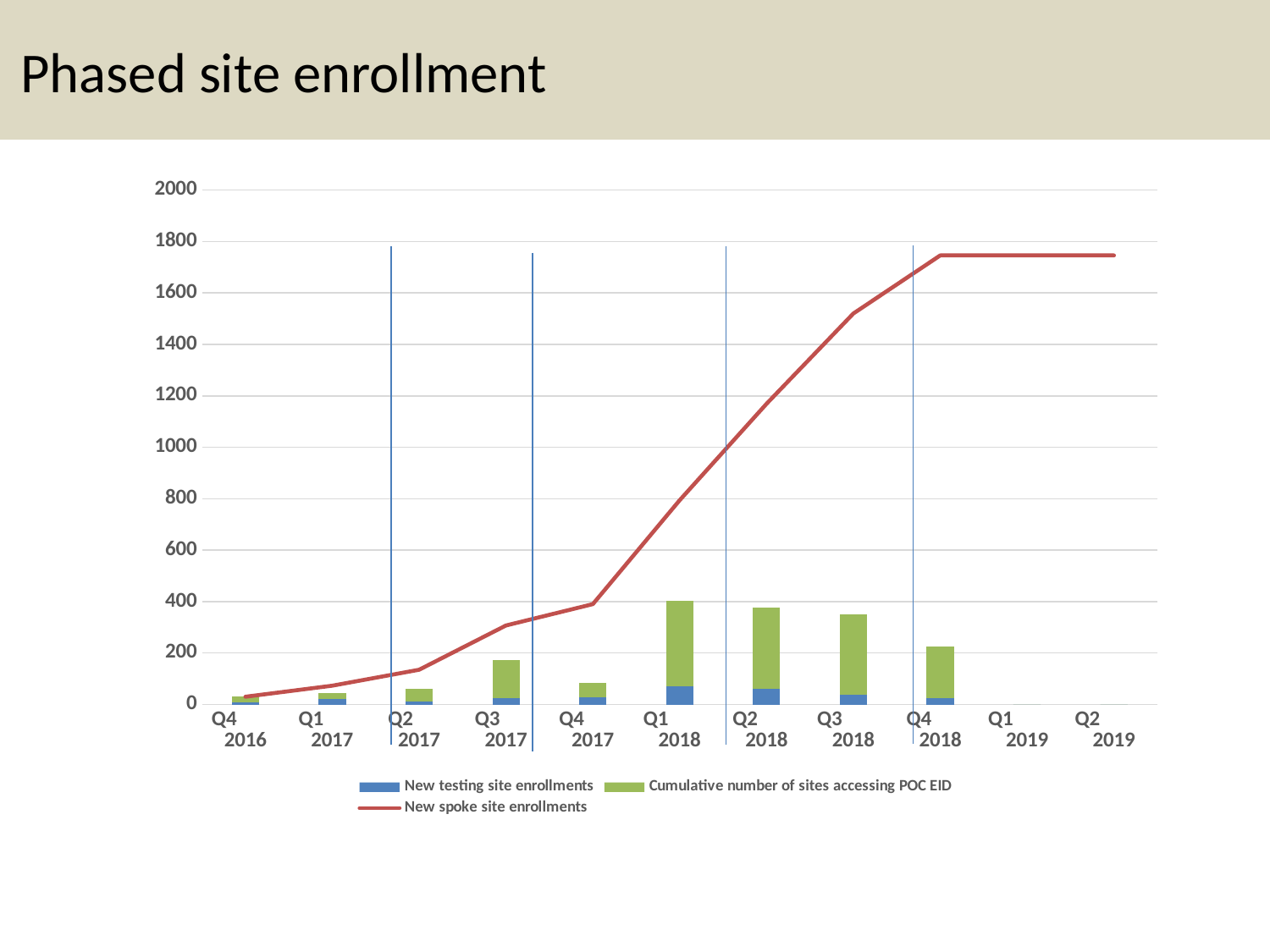
Does the New spoke site enrollments line rise or fall from Q4 2016 to Q4 2018? Rise How many quarters are shown on the x axis of the chart? 11 Which series is drawn as a red line in the chart? New spoke site enrollments Is the value of the New spoke site enrollments line at Q3 2018 greater or less than 1400? greater Which quarter has the tallest stacked bar in the chart? Q1 2018 What is the title of the slide's chart? Phased site enrollment Is the value of the New spoke site enrollments line at Q1 2018 greater or less than 600? greater Is the total height of the stacked bar for Q3 2018 greater or less than 400? less Which stacked bar is taller, Q1 2018 or Q4 2017? Q1 2018 What kind of chart is shown on the slide? Combination of stacked bar chart and line chart How many series does the chart's legend list? 3